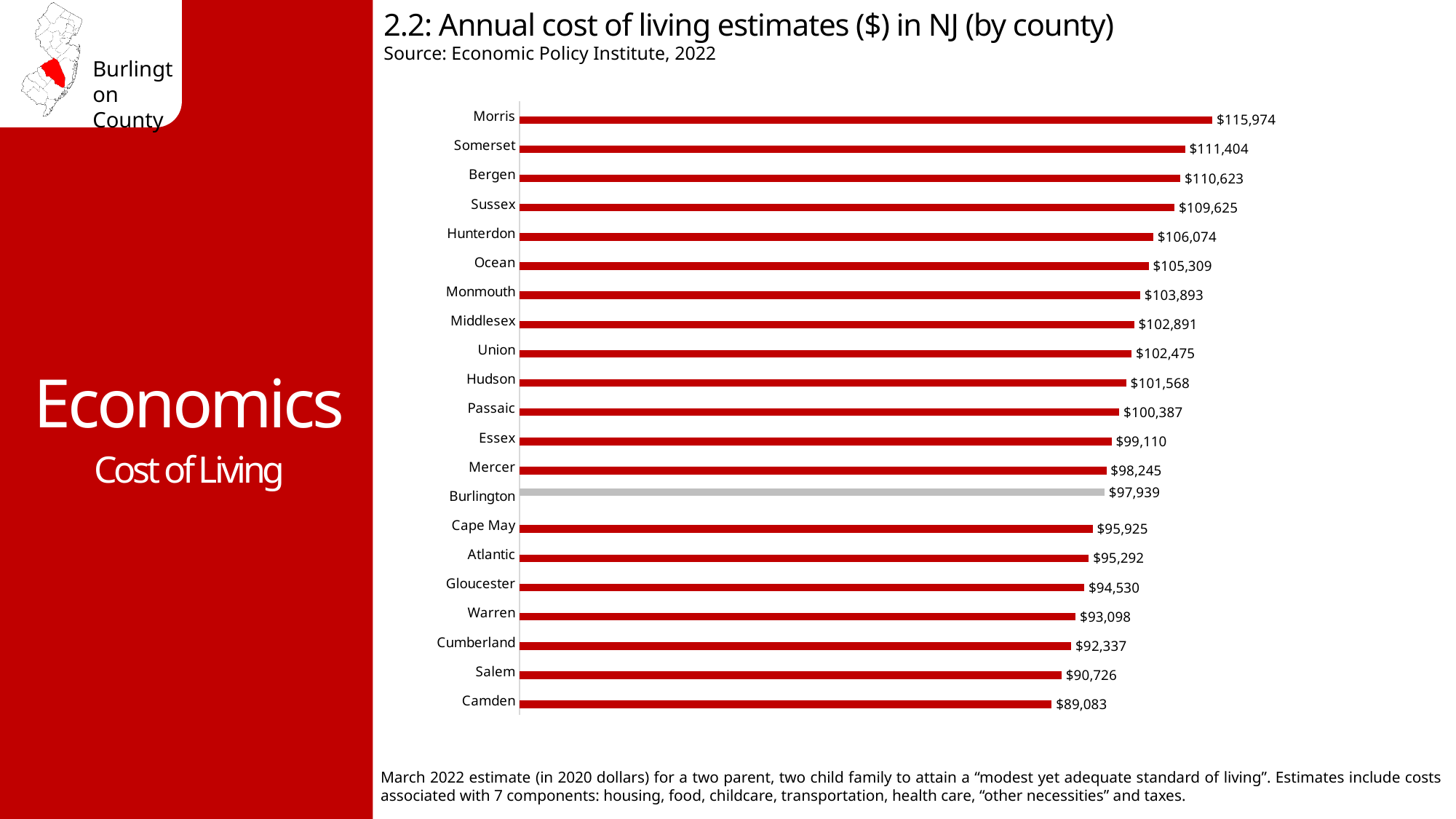
Which county has the lowest annual cost of living estimate? Camden Which county has a higher cost of living estimate, Salem or Warren? Warren How much higher is Burlington County's cost of living estimate than Camden County's? $8,856 What is the annual cost of living estimate for Gloucester County? $94,530 Which county has the highest annual cost of living estimate? Morris Which county's bar is shown in grey instead of red? Burlington How many counties are shown in the chart? 21 What type of chart is used to show the cost of living estimates? Bar chart What is the annual cost of living estimate for Burlington County? $97,939 What is the difference between the cost of living estimates for Morris and Camden counties? $26,891 What is the annual cost of living estimate for Morris County? $115,974 Which county has a higher cost of living estimate, Hunterdon or Ocean? Hunterdon